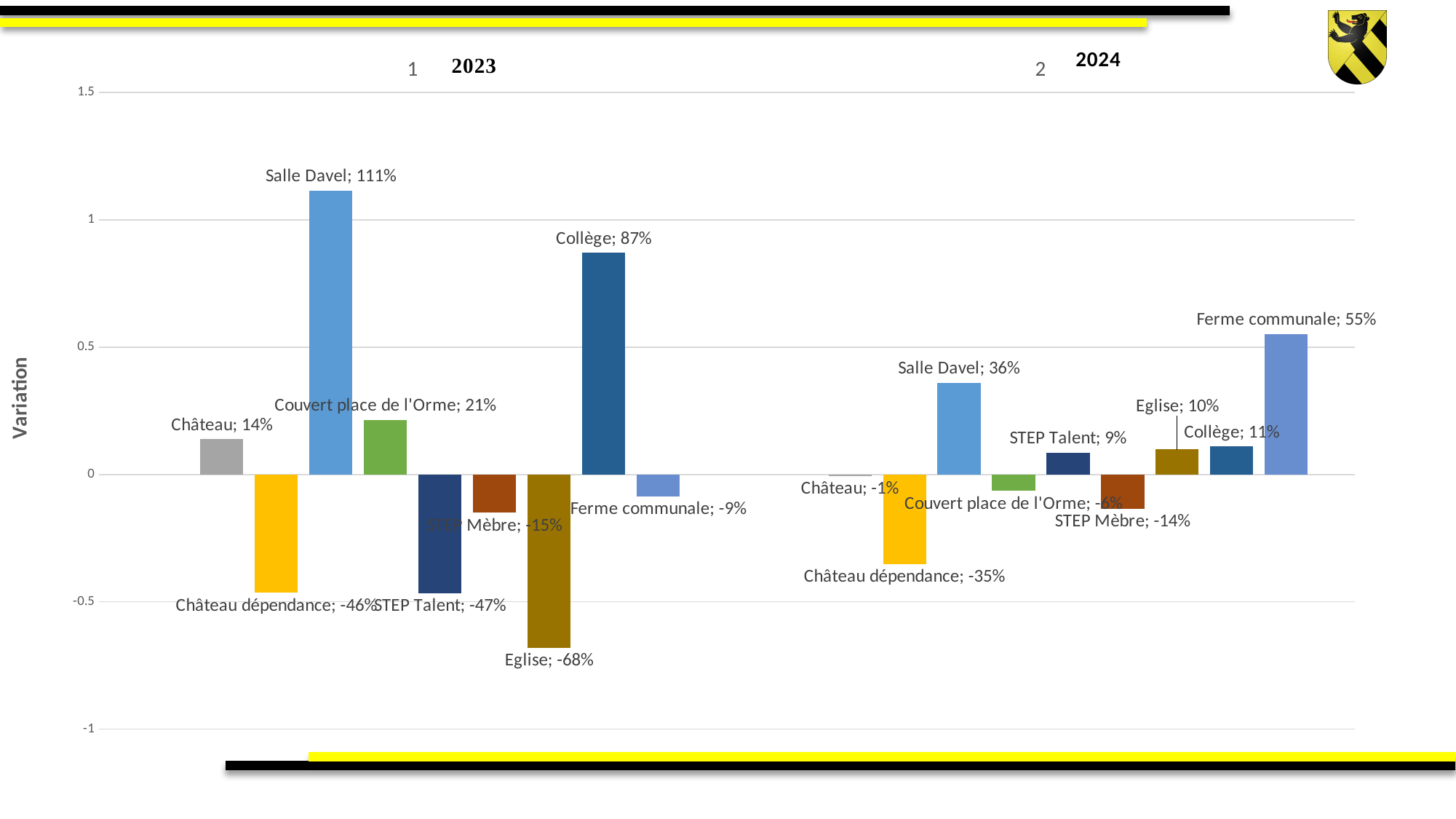
What kind of chart is shown on the slide? bar chart What is the difference between the variation for Salle Davel in 2023 and in 2024? 75% Which building has the lowest variation in 2023? Eglise What is the variation for Ferme communale in 2024? 55% Which building has the lowest variation in 2024? Château dépendance What is the variation for Salle Davel in 2023? 111% Which building has the highest variation in 2023? Salle Davel What is the label of the vertical axis? Variation Which is larger, the variation for Collège in 2023 or the variation for Ferme communale in 2024? Collège in 2023 Which building has the highest variation in 2024? Ferme communale What is the variation for Eglise in 2023? -68% What is the variation for Château dépendance in 2024? -35%